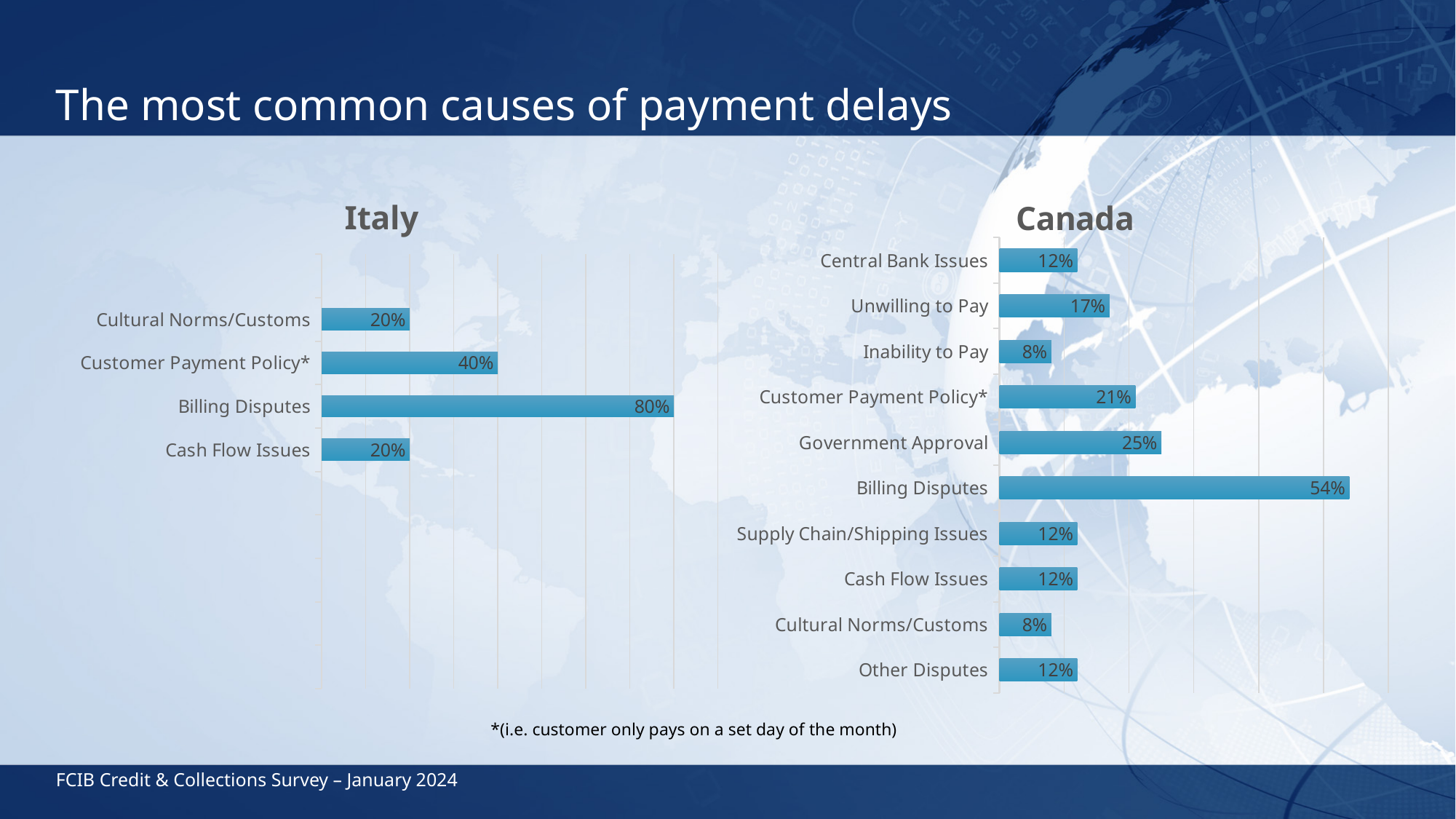
In the Canada chart, what is the value for Government Approval? 25% In the Canada chart, what is the value for Unwilling to Pay? 17% In the Canada chart, which category has the highest value? Billing Disputes In the Italy chart, what is the value for Customer Payment Policy*? 40% In the Italy chart, how many categories are shown? 4 In the Canada chart, how many categories are shown? 10 In the Italy chart, what is the difference between Billing Disputes and Customer Payment Policy*? 40% In the Italy chart, what is the value for Billing Disputes? 80% What type of chart is the Canada chart? Bar chart In the Canada chart, which is larger, Customer Payment Policy* or Central Bank Issues? Customer Payment Policy* In the Italy chart, which category has the highest value? Billing Disputes In the Canada chart, what is the difference between Billing Disputes and Government Approval? 29%